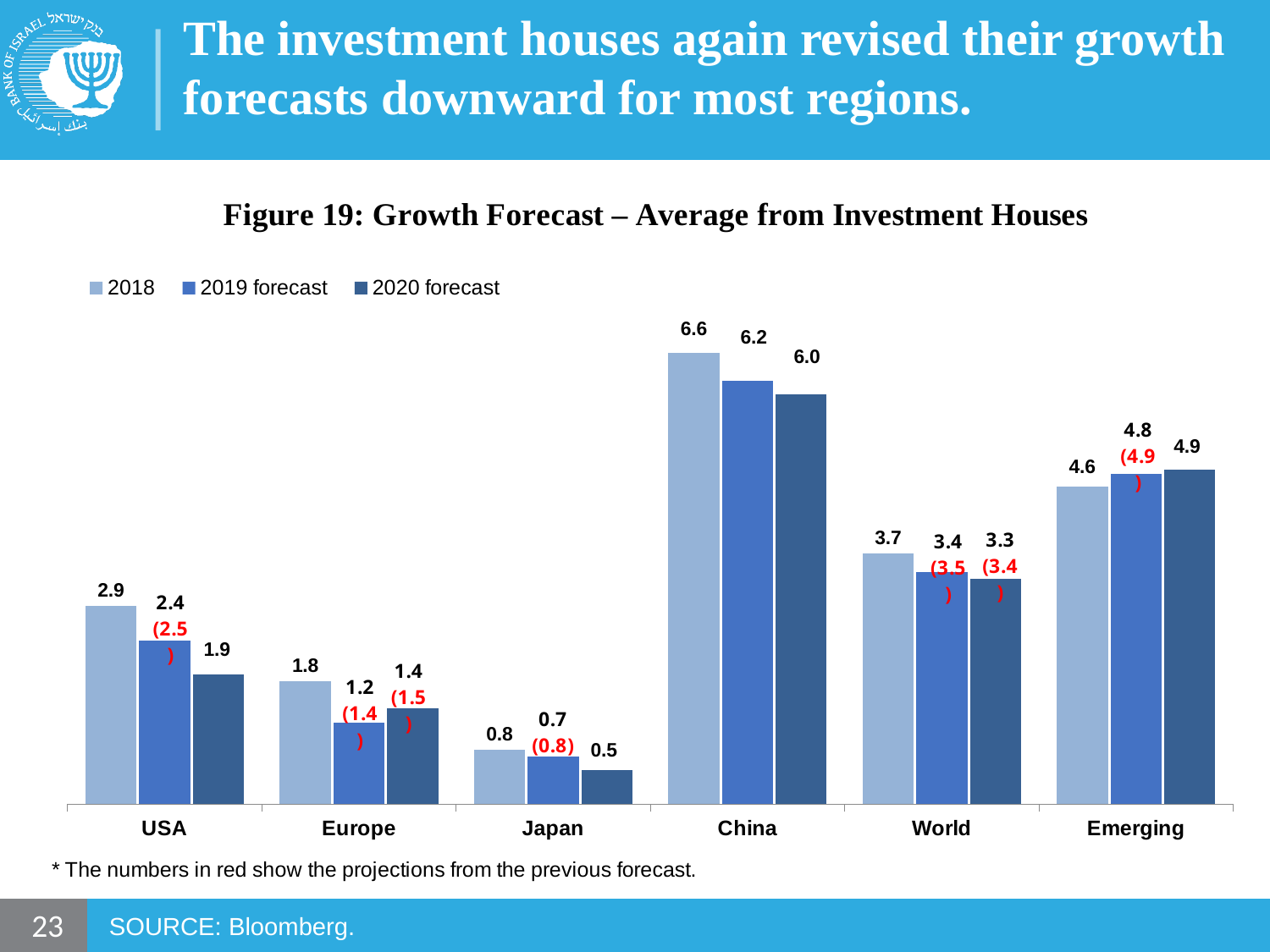
For Japan, do the values rise or fall from 2018 to the 2020 forecast? Fall What kind of chart is shown? Bar chart How many series does the legend list? 3 What was the previous forecast for the USA in 2019, shown in red? 2.5 What is the 2019 forecast value for Europe? 1.2 Which region has the highest 2018 value? China What is the 2020 forecast value for Emerging? 4.9 How many regions are shown on the x axis? 6 Which is larger for the World: the 2019 forecast or the 2020 forecast? 2019 forecast What is the 2018 value for China? 6.6 What is the difference between the 2018 value and the 2020 forecast value for the USA? 1.0 Which region has the lowest 2020 forecast value? Japan